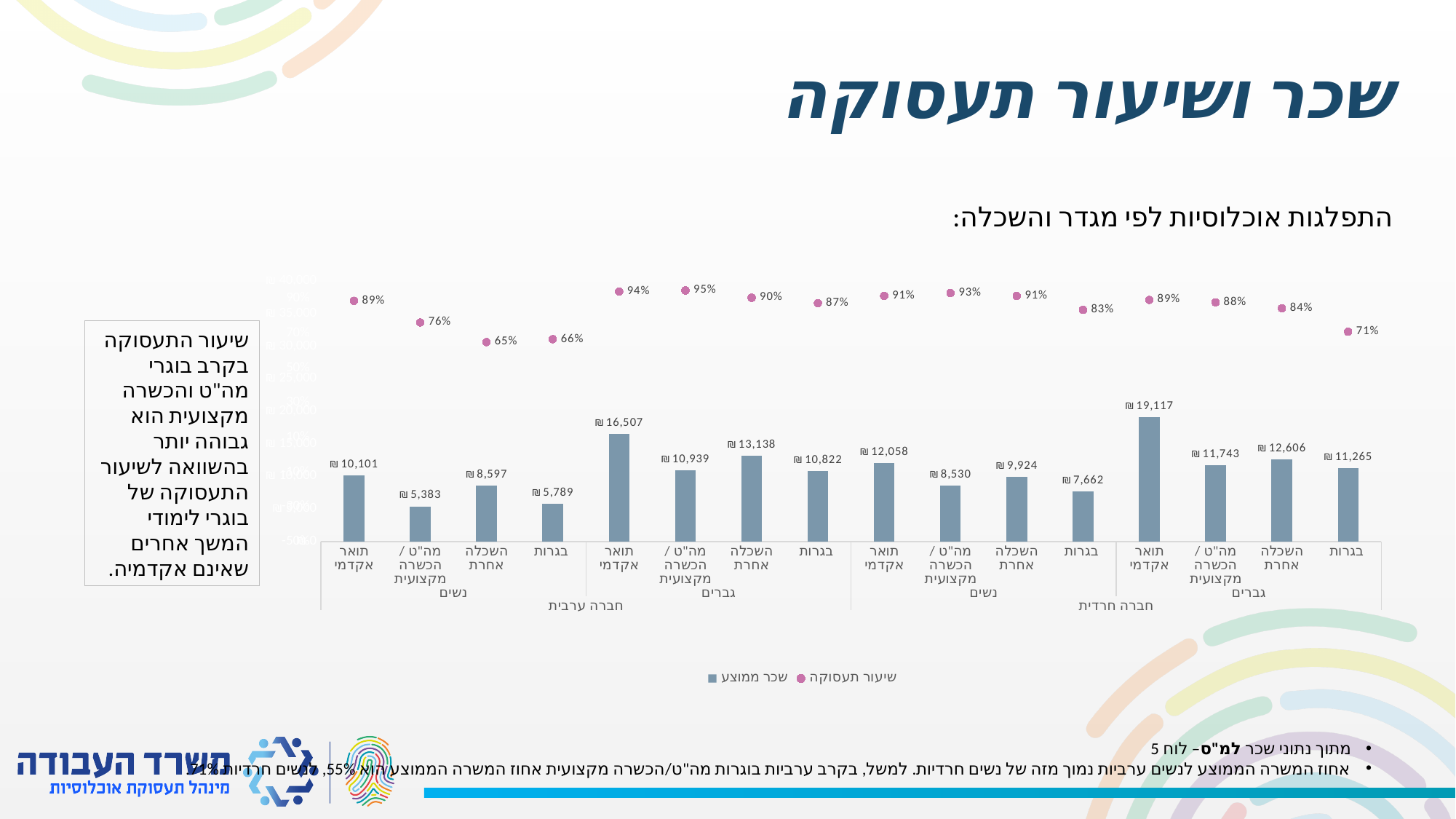
What kind of chart is shown on the slide? A combination chart of bars (average salary) and dot markers (employment rate) Which has a higher average salary: Arab society men with השכלה אחרת or Haredi society men with השכלה אחרת? Arab society men with השכלה אחרת (₪13,138) How many series does the legend list? 2 Which category has the lowest average salary bar on the chart? חברה ערבית, נשים, מה"ט / הכשרה מקצועית What is the average salary for Arab society women (נשים) with בגרות? ₪5,789 What is the average salary (שכר ממוצע) for Arab society (חברה ערבית) men (גברים) with an academic degree (תואר אקדמי)? ₪16,507 What is the difference in average salary between Haredi society men with תואר אקדמי and Haredi society men with בגרות? ₪7,852 How many categories (bars) are plotted on the chart? 16 What is the employment rate (שיעור תעסוקה) for Haredi society (חברה חרדית) women (נשים) with מה"ט / הכשרה מקצועית? 93% Which category has the highest average salary bar on the chart? חברה חרדית, גברים, תואר אקדמי What are the two series named in the legend? שכר ממוצע and שיעור תעסוקה Which category has the lowest employment rate on the chart? חברה ערבית, נשים, השכלה אחרת